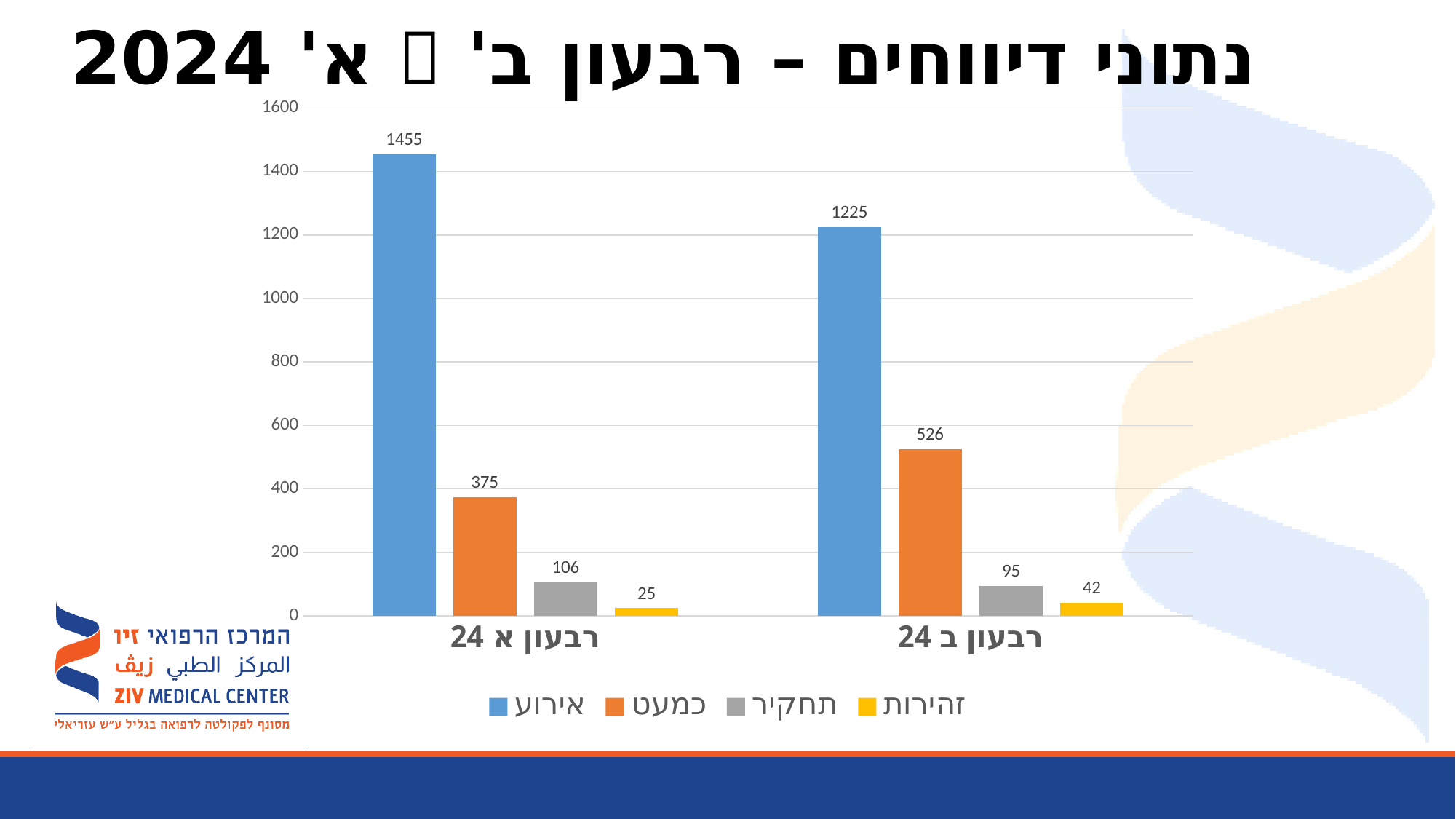
What is the value of the תחקיר series for רבעון ב 24? 95 What is the value of the כמעט series for רבעון ב 24? 526 How many series does the legend list? 4 Which series has the lowest value for רבעון א 24? זהירות Which is larger: the כמעט value for רבעון א 24 or for רבעון ב 24? רבעון ב 24 What kind of chart is shown on the slide? bar chart What is the difference between the אירוע values for רבעון א 24 and רבעון ב 24? 230 Which series has the highest value for רבעון ב 24? אירוע What is the value of the אירוע series for רבעון א 24? 1455 Is the value of the אירוע series for רבעון ב 24 greater or less than 1200? greater How many categories are shown on the x axis? 2 What is the value of the זהירות series for רבעון א 24? 25